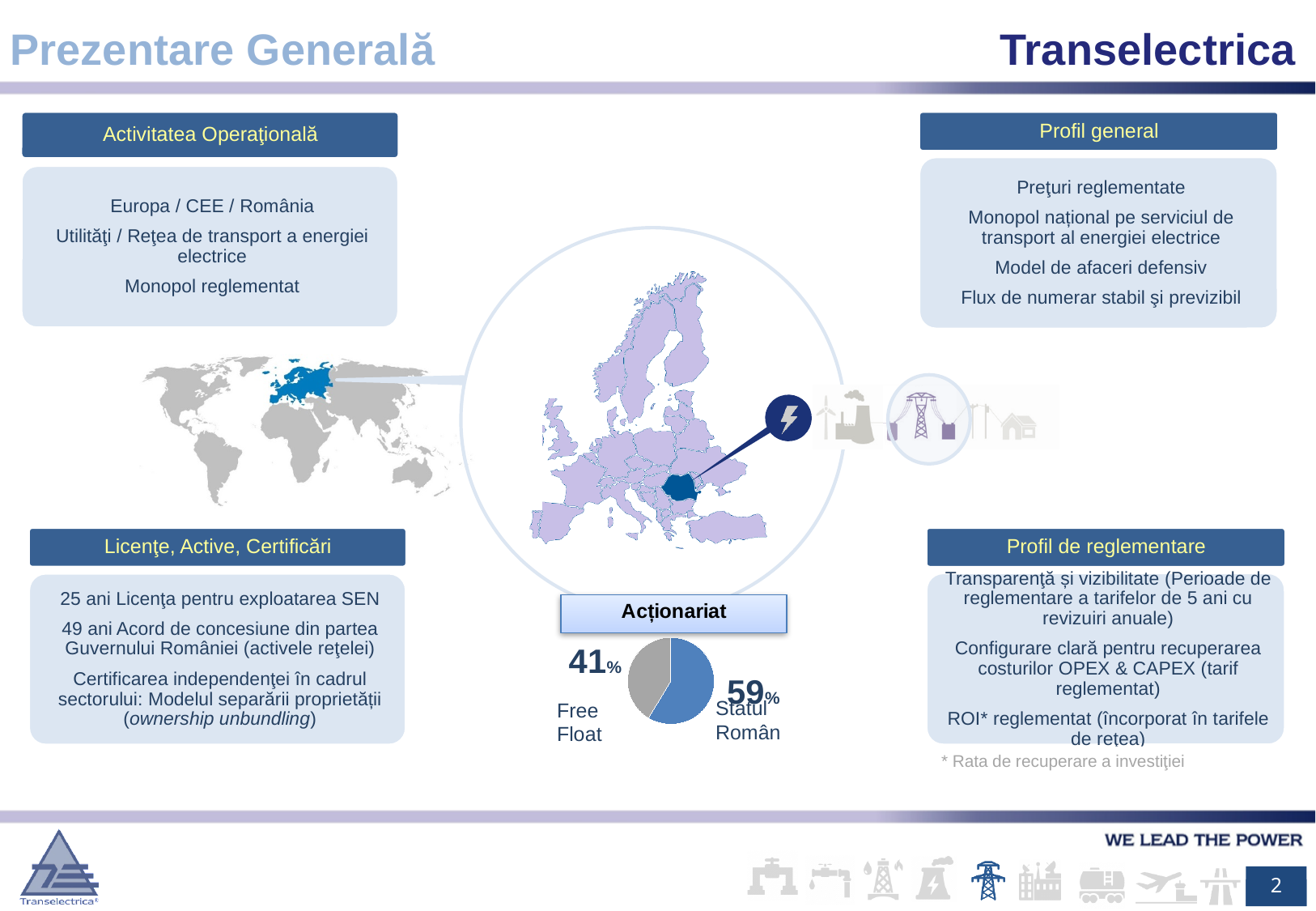
In the "Acționariat" pie chart, what colour is the Statul Român slice? blue In the "Acționariat" pie chart, which is larger: Free Float or Statul Român? Statul Român What is the title of the pie chart on the slide? Acționariat In the "Acționariat" pie chart, what is the difference in percentage points between Statul Român and Free Float? 18 Is the Free Float share in the "Acționariat" pie chart greater or less than 50%? less What kind of chart is shown under the "Acționariat" heading? pie chart In the "Acționariat" pie chart, what share is held by Statul Român? 59% How many slices does the "Acționariat" pie chart have? 2 In the "Acționariat" pie chart, which slice is the largest? Statul Român In the "Acționariat" pie chart, which slice is the smallest? Free Float In the "Acționariat" pie chart, what share is Free Float? 41%